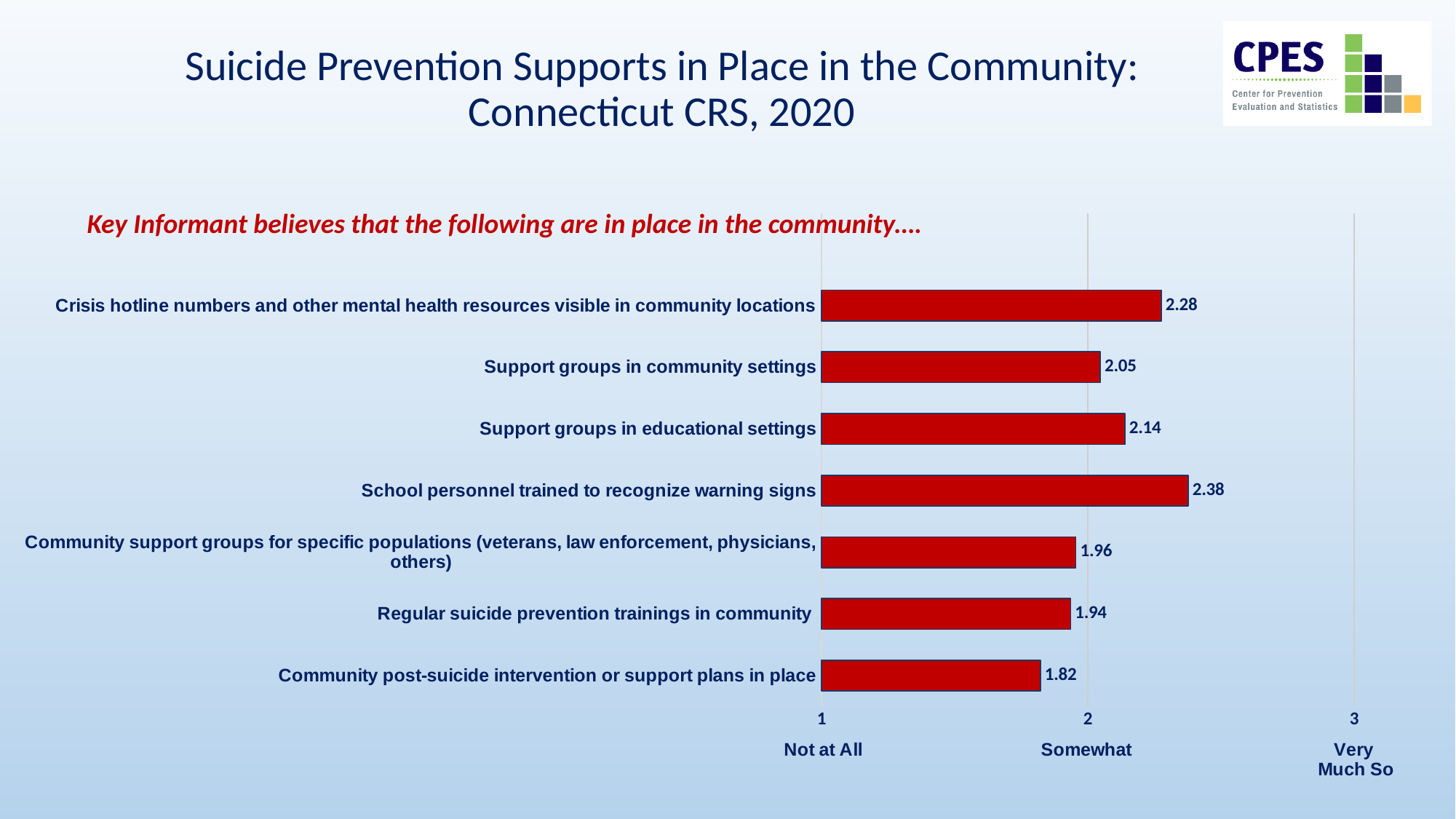
Which is larger: the value for 'Support groups in community settings' or the value for 'Support groups in educational settings'? Support groups in educational settings What kind of chart is shown on the slide? Bar chart What is the value for 'Support groups in educational settings'? 2.14 What is the value for 'Community post-suicide intervention or support plans in place'? 1.82 What is the value for 'Crisis hotline numbers and other mental health resources visible in community locations'? 2.28 Which category has the lowest value? Community post-suicide intervention or support plans in place What is the value for 'School personnel trained to recognize warning signs'? 2.38 What is the difference between the values for 'School personnel trained to recognize warning signs' and 'Community post-suicide intervention or support plans in place'? 0.56 What label does the x axis show at the value 3? Very Much So How many categories are shown in the chart? 7 Which category has the highest value? School personnel trained to recognize warning signs Is the value for 'Regular suicide prevention trainings in community' greater or less than 2? less